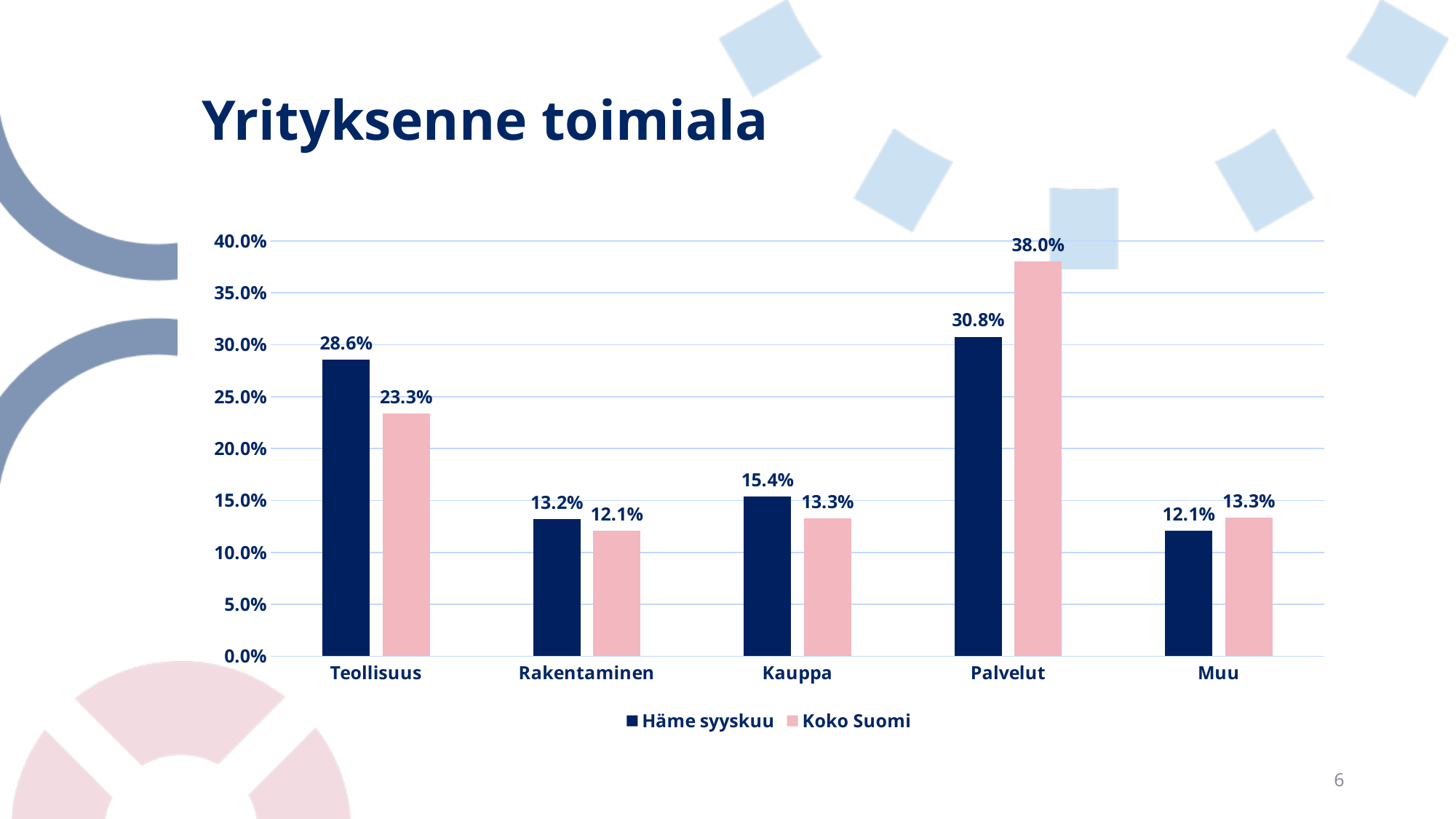
Which category has the highest value for Häme syyskuu? Palvelut What is the value for Häme syyskuu in the Teollisuus category? 28.6% Is the value for Koko Suomi in Palvelut greater or less than 35.0%? greater How many series does the legend list? 2 Which is larger for Kauppa: Häme syyskuu or Koko Suomi? Häme syyskuu How many categories are shown on the x axis? 5 What is the value for Koko Suomi in the Palvelut category? 38.0% What kind of chart is shown on the slide? Bar chart What is the difference between the Häme syyskuu and Koko Suomi values for Teollisuus? 5.3% What is the value for Koko Suomi in the Rakentaminen category? 12.1% Which category has the lowest value for Häme syyskuu? Muu What is the difference between the Koko Suomi and Häme syyskuu values for Palvelut? 7.2%